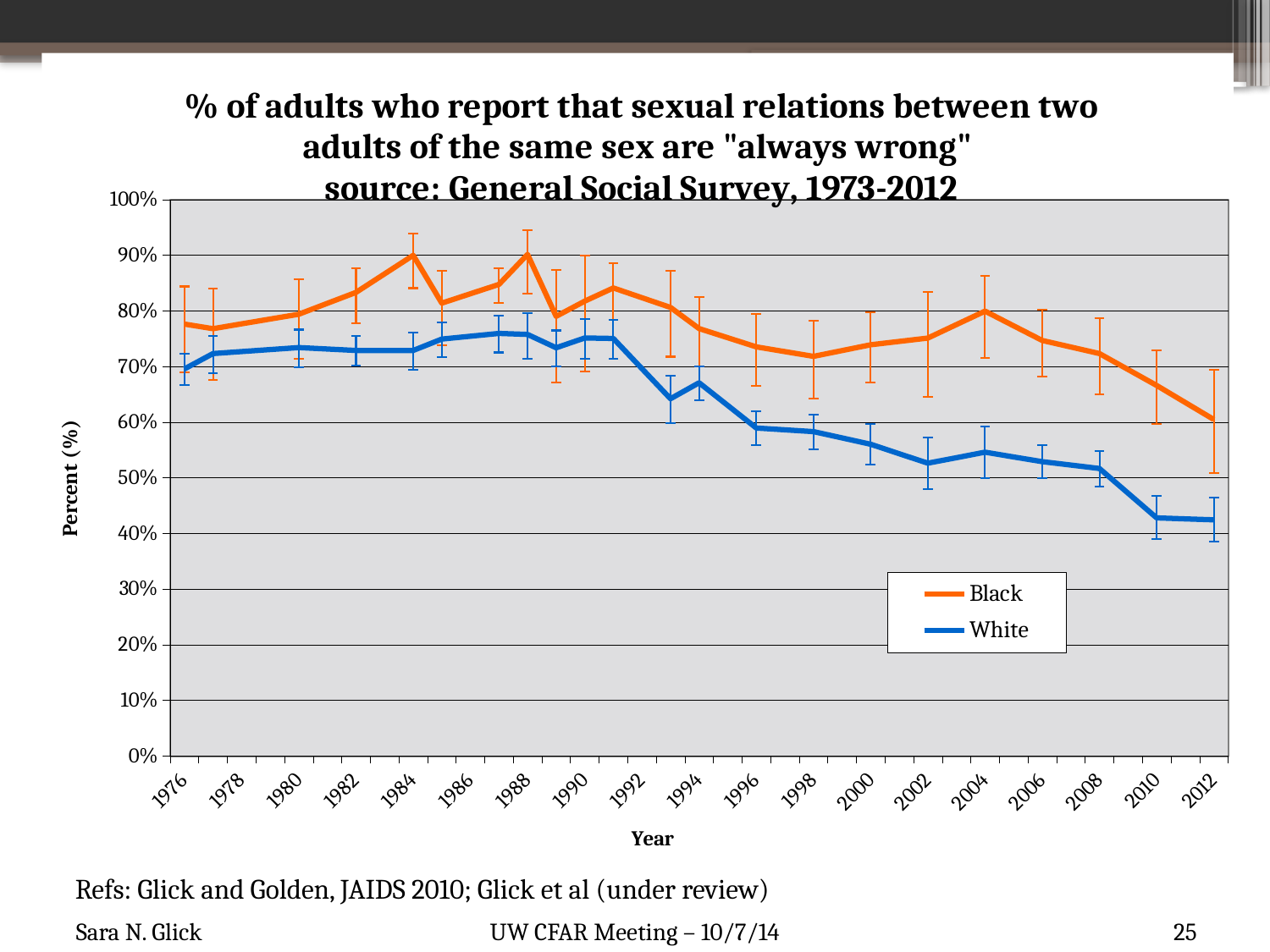
Is the value for White in 2002 greater or less than 60%? less Is the value for Black in 1998 greater or less than 80%? less Is the value for White in 2012 greater or less than 50%? less In 2012, which series has the higher value, Black or White? Black What is the title of the y axis? Percent (%) How many series does the legend list? 2 What kind of chart is shown on the slide? line chart Which series is shown in orange? Black Which series has the lower value in 2000, Black or White? White Does the White series generally rise or fall from 1976 to 2012? fall